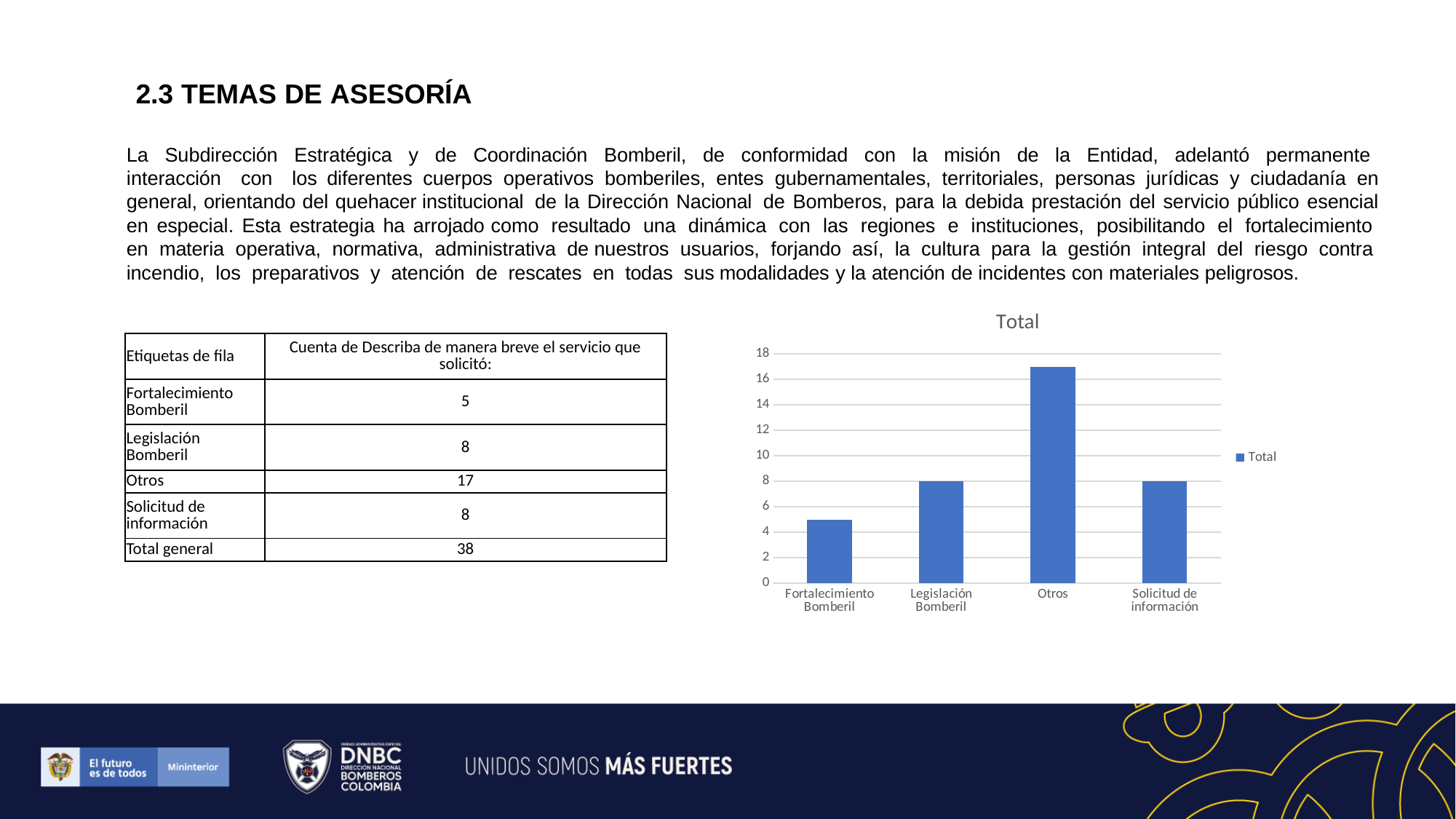
What is the title of the chart? Total Which category has the lowest bar in the chart? Fortalecimiento Bomberil Which is larger, the value for Otros or the value for Solicitud de información? Otros Is the value for Fortalecimiento Bomberil greater or less than 6? less What is the value for Legislación Bomberil in the chart? 8 Which category has the highest bar in the chart? Otros Is the value for Otros greater or less than 16? greater What kind of chart is shown on the slide? bar chart How many series does the chart legend list? 1 What is the difference between the value for Otros and the value for Fortalecimiento Bomberil? 12 How many categories are shown on the x axis of the chart? 4 What is the value for Otros in the chart? 17